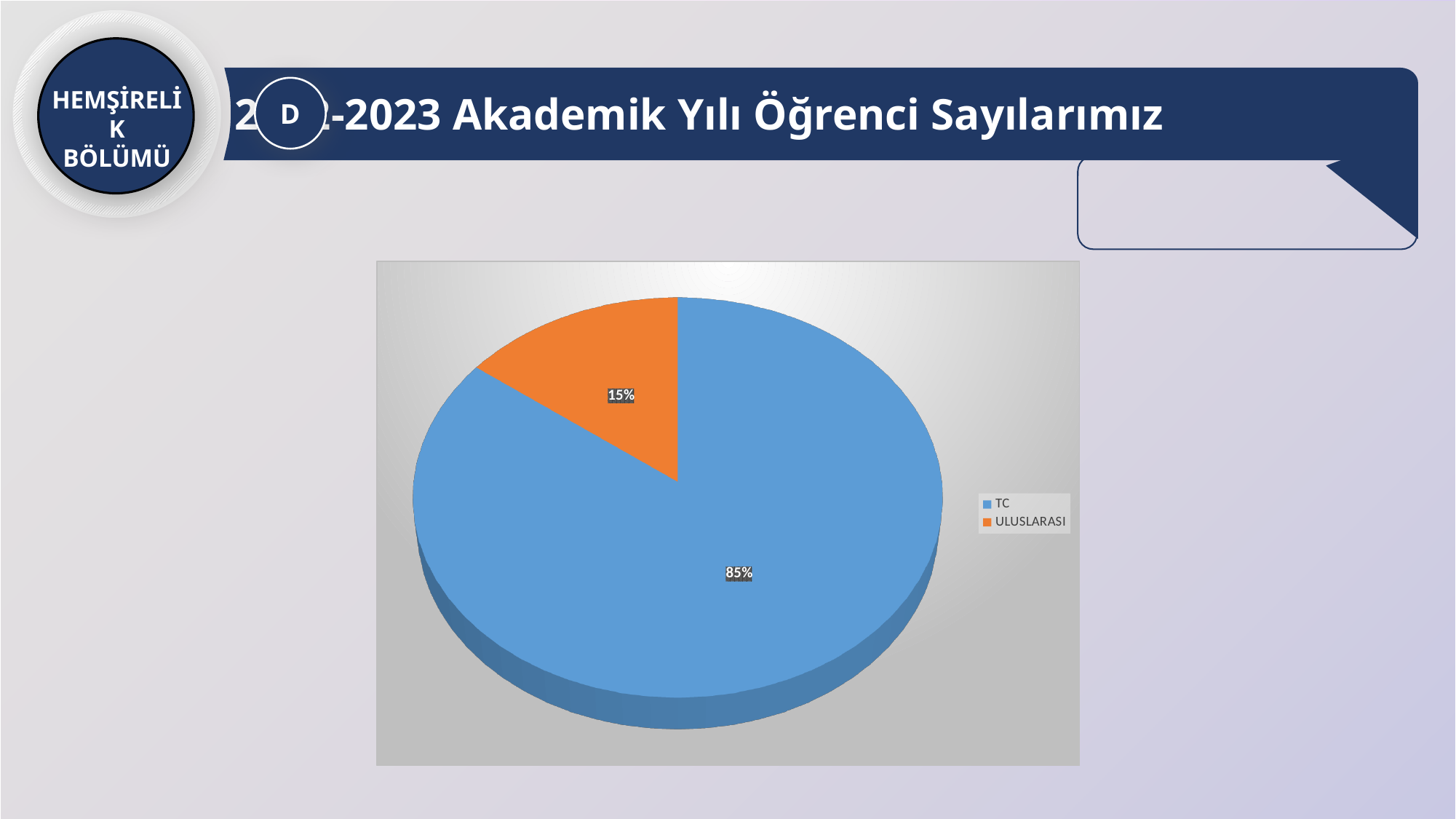
Which category has the largest slice of the pie? TC What share of the pie does the ULUSLARASI slice represent? 15% What colour is the ULUSLARASI slice? orange How many categories are shown in the pie chart? 2 How many entries does the legend list? 2 What share of the pie does the TC slice represent? 85% Which category has the smallest slice of the pie? ULUSLARASI What is the difference in percentage points between the TC and ULUSLARASI slices? 70 What colour is the TC slice? blue What kind of chart is shown on the slide? pie chart Which slice is larger, TC or ULUSLARASI? TC